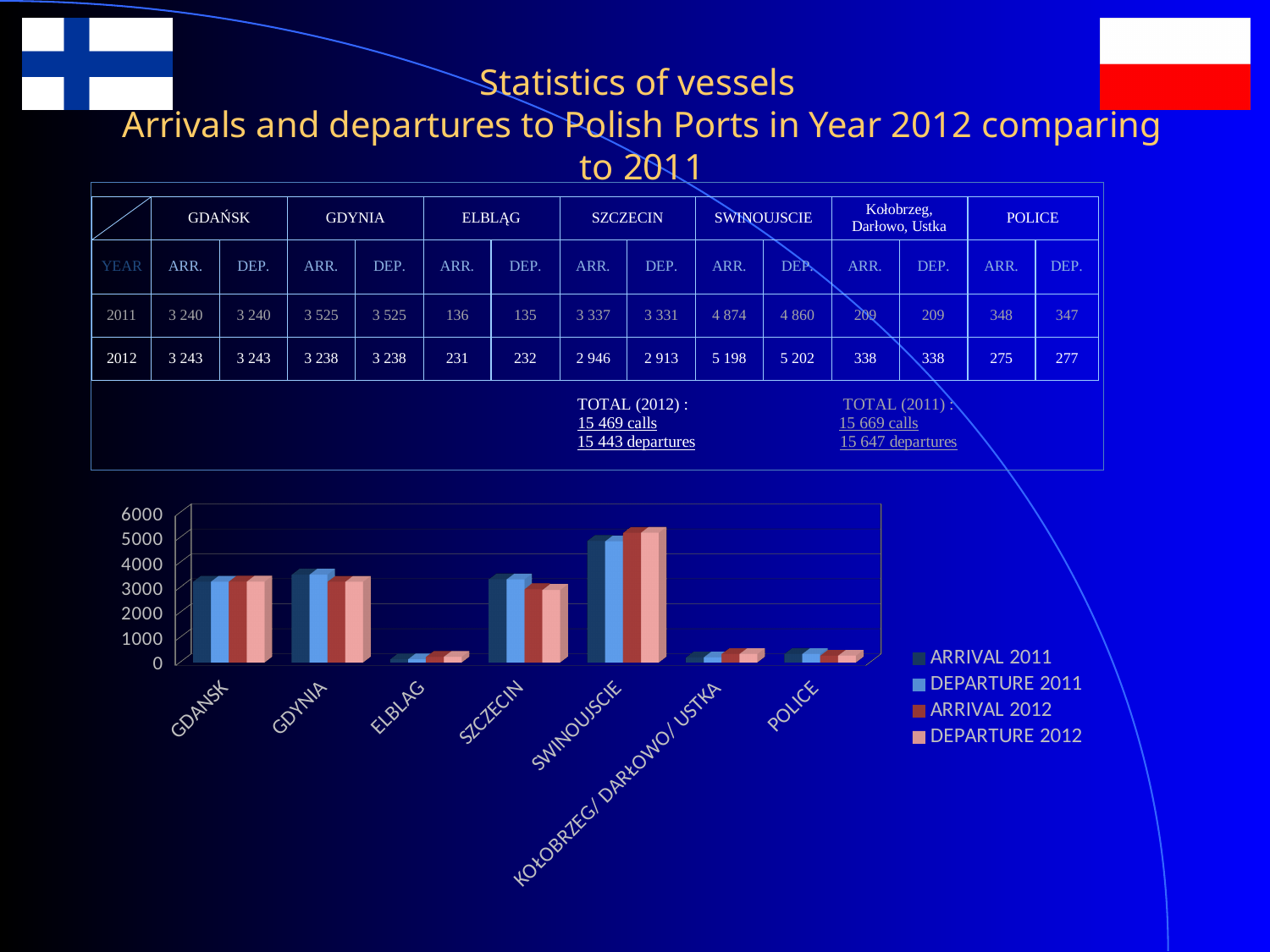
Is the ARRIVAL 2012 value for SWINOUJSCIE greater or less than 5000? greater Which is larger, the ARRIVAL 2011 value for GDYNIA or for GDANSK? GDYNIA What is the difference between the ARRIVAL 2012 and ARRIVAL 2011 values for SWINOUJSCIE? 324 Is the ARRIVAL 2011 value for GDANSK greater or less than 3000? greater How many series does the chart legend list? 4 For SWINOUJSCIE, which is larger, ARRIVAL 2012 or ARRIVAL 2011? ARRIVAL 2012 How many ports (categories) are shown on the x axis of the chart? 7 Is the ARRIVAL 2011 value for GDYNIA greater or less than 4000? less Which port has the lowest ARRIVAL 2011 value? ELBLAG What is the ARRIVAL 2012 value for SWINOUJSCIE? 5 198 What kind of chart is shown on the slide? bar chart Which port has the highest bars in the chart? SWINOUJSCIE